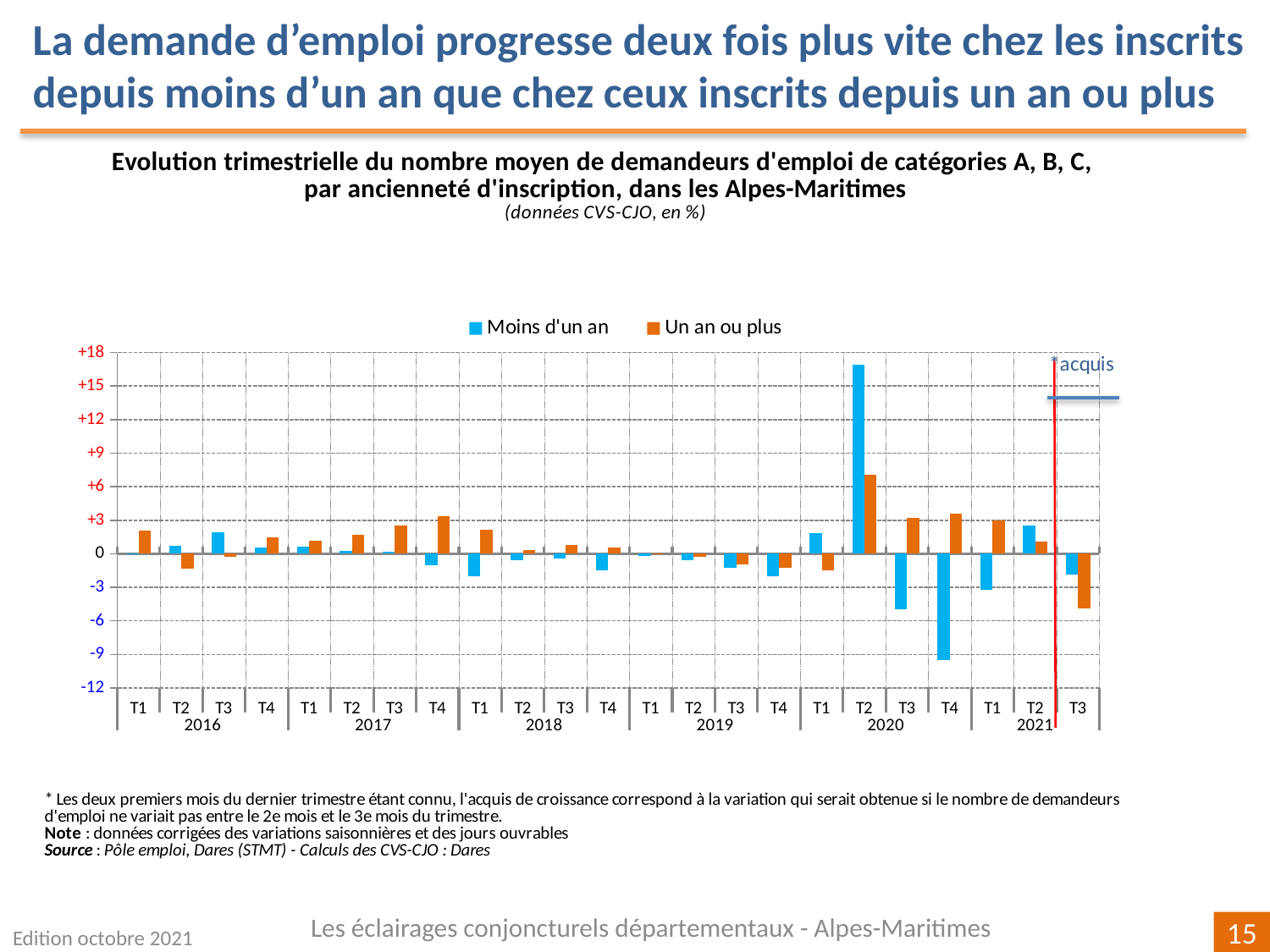
In which quarter is the value for 'Moins d'un an' lowest? T4 2020 How many quarters are plotted on the x axis? 23 In which quarter is the value for 'Moins d'un an' highest? T2 2020 How many series does the legend list? 2 What are the two series named in the legend? Moins d'un an; Un an ou plus In which quarter is the value for 'Un an ou plus' lowest? T3 2021 Is the value for 'Moins d'un an' in T2 2020 greater or less than +15? greater What kind of chart is shown on the slide? Bar chart Is the value for 'Moins d'un an' in T4 2020 greater or less than -6? less In which quarter is the value for 'Un an ou plus' highest? T2 2020 In T2 2020, which series has the larger value, 'Moins d'un an' or 'Un an ou plus'? Moins d'un an Which quarter is marked with the annotation '* acquis'? T3 2021